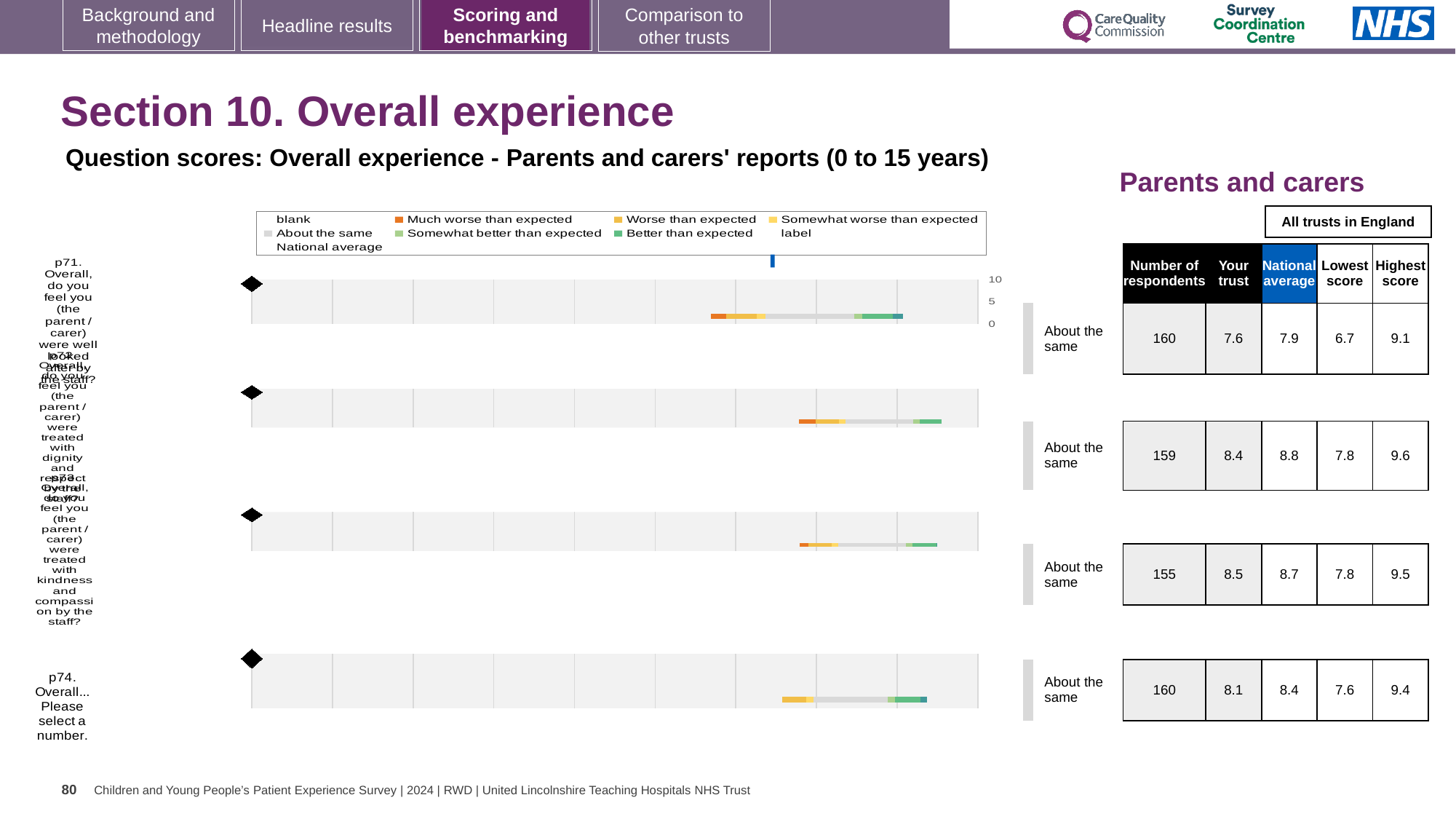
What is the title of the chart on this slide? Question scores: Overall experience - Parents and carers' reports (0 to 15 years) How many respondents answered p73? 155 What kind of chart is used to show the question scores on this slide? bar chart What is the national average score for p74 (Overall... Please select a number)? 8.4 For p73, which is larger: the 'Your trust' score or the national average? National average Which question has the highest 'Your trust' score? p73 For p72, what is the difference between the national average and the 'Your trust' score? 0.4 Which question has the lowest 'Your trust' score? p71 How many questions (rows) are plotted in the question scores chart? 4 In the chart legend, what colour represents 'Much worse than expected'? orange What benchmark category is shown for p71? About the same What is the 'Your trust' score for p71 (Overall, do you feel you were well looked after by the staff?)? 7.6